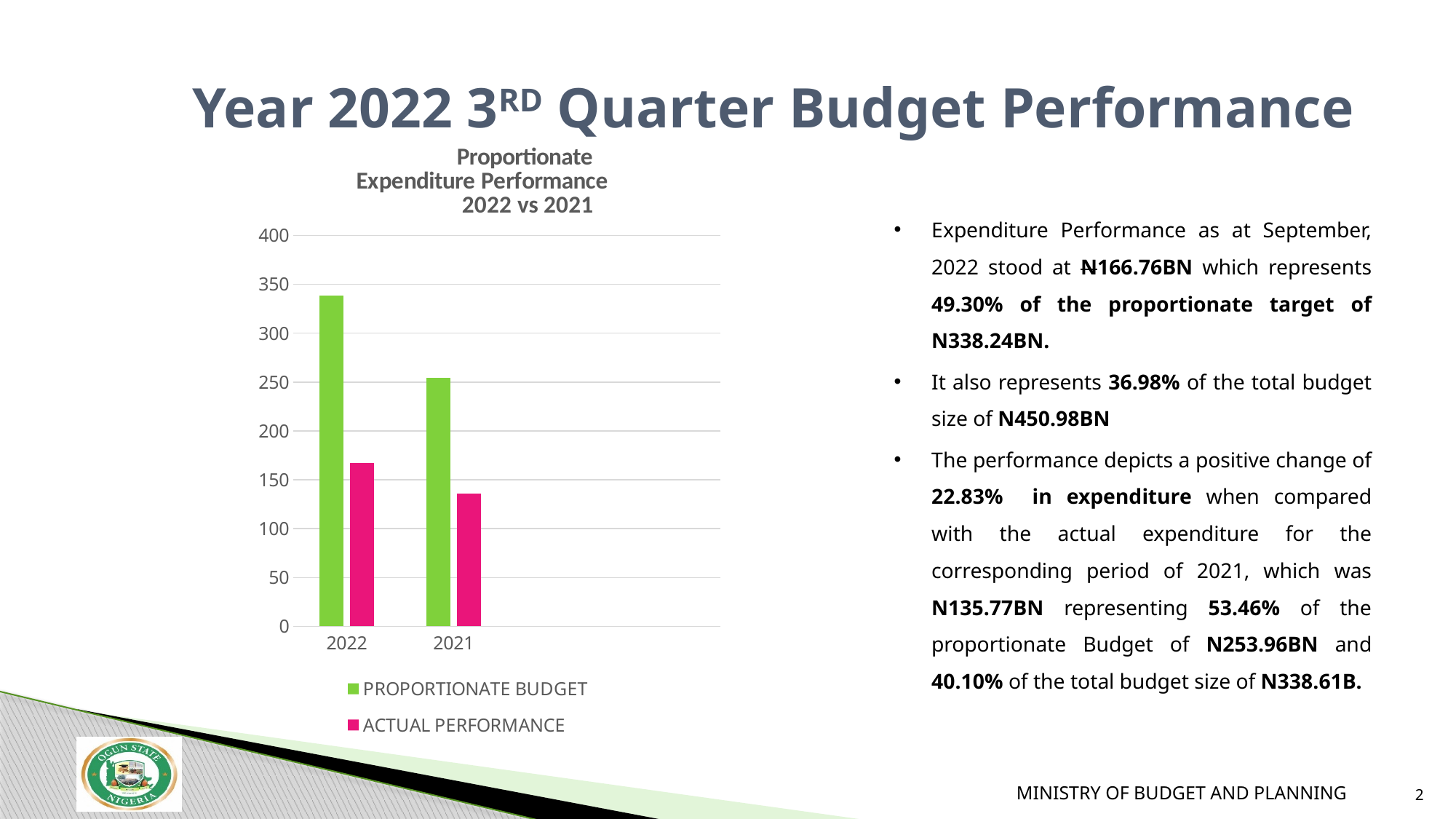
What is the title of the chart? Proportionate Expenditure Performance 2022 vs 2021 How many series does the chart legend list? 2 Which bar is the shortest in the chart? ACTUAL PERFORMANCE for 2021 How many year categories are shown on the x axis of the chart? 2 Is the ACTUAL PERFORMANCE value for 2021 greater or less than 150? less Is the ACTUAL PERFORMANCE value for 2022 greater or less than 200? less Which bar is the tallest in the chart? PROPORTIONATE BUDGET for 2022 Which is larger in the chart: the ACTUAL PERFORMANCE for 2022 or the ACTUAL PERFORMANCE for 2021? ACTUAL PERFORMANCE for 2022 What kind of chart is shown on the slide? bar chart Is the PROPORTIONATE BUDGET value for 2022 greater or less than 300? greater Which series is shown in green in the chart? PROPORTIONATE BUDGET Which is larger in the chart: the PROPORTIONATE BUDGET for 2022 or the PROPORTIONATE BUDGET for 2021? PROPORTIONATE BUDGET for 2022